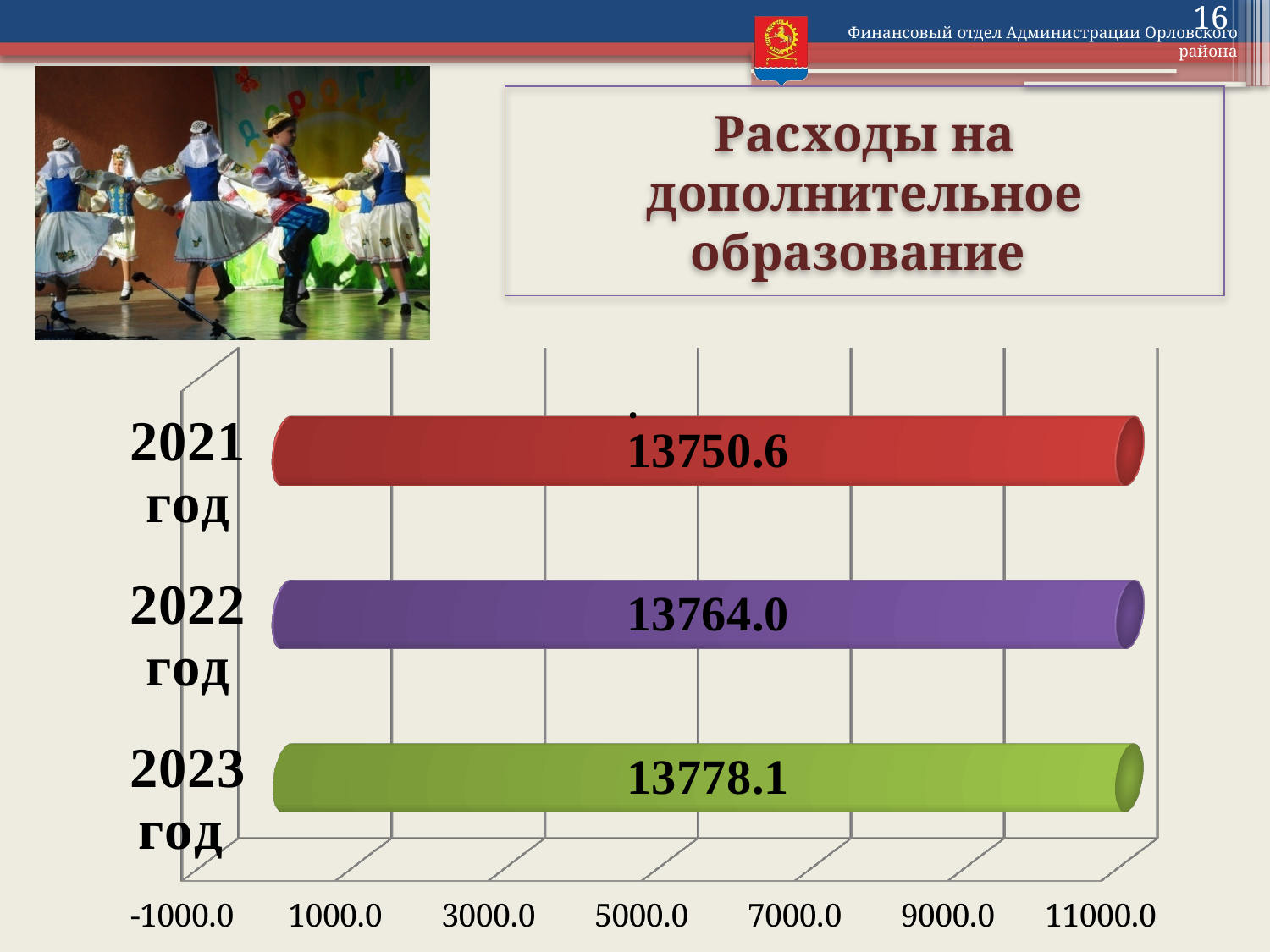
Is the value for 2021 год greater or less than 11000.0? greater What is the difference between the values for 2022 год and 2021 год? 13.4 Which year has the lowest value? 2021 год What is the title of the chart? Расходы на дополнительное образование What is the difference between the values for 2023 год and 2021 год? 27.5 How many categories are shown in the chart? 3 Which year has the highest value? 2023 год What kind of chart is shown on the slide? bar chart What is the value for 2021 год? 13750.6 What is the value for 2022 год? 13764.0 Which is larger, the value for 2023 год or the value for 2022 год? 2023 год What is the value for 2023 год? 13778.1